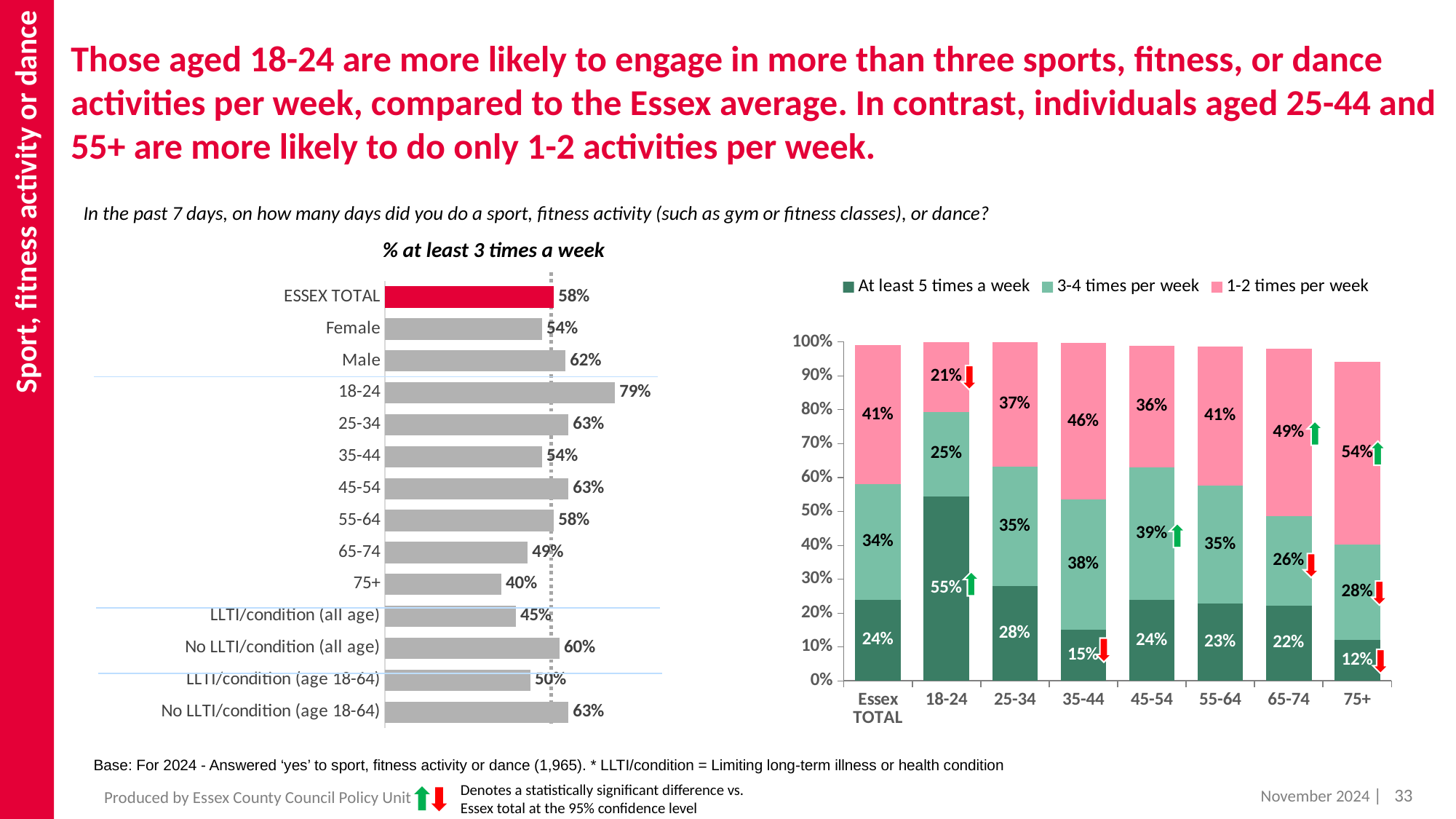
In the '% at least 3 times a week' chart, what is the value for 18-24? 79% In the stacked bar chart on the right, what is the '1-2 times per week' value for 75+? 54% In the '% at least 3 times a week' chart, which is larger: LLTI/condition (all age) or No LLTI/condition (all age)? No LLTI/condition (all age) How many series does the legend of the stacked bar chart on the right list? 3 In the '% at least 3 times a week' chart, what is the difference between Male and Female? 8% In the stacked bar chart on the right, which age group has the lowest 'At least 5 times a week' value? 75+ In the '% at least 3 times a week' chart, which category has the lowest value? 75+ In the stacked bar chart on the right, what is the 'At least 5 times a week' value for 18-24? 55% What kind of chart is the '% at least 3 times a week' chart? Bar chart In the '% at least 3 times a week' chart, how many categories are shown? 14 In the stacked bar chart on the right, how many categories are shown on the x axis? 8 In the stacked bar chart on the right, what is the difference between the '3-4 times per week' values for 45-54 and 65-74? 13%